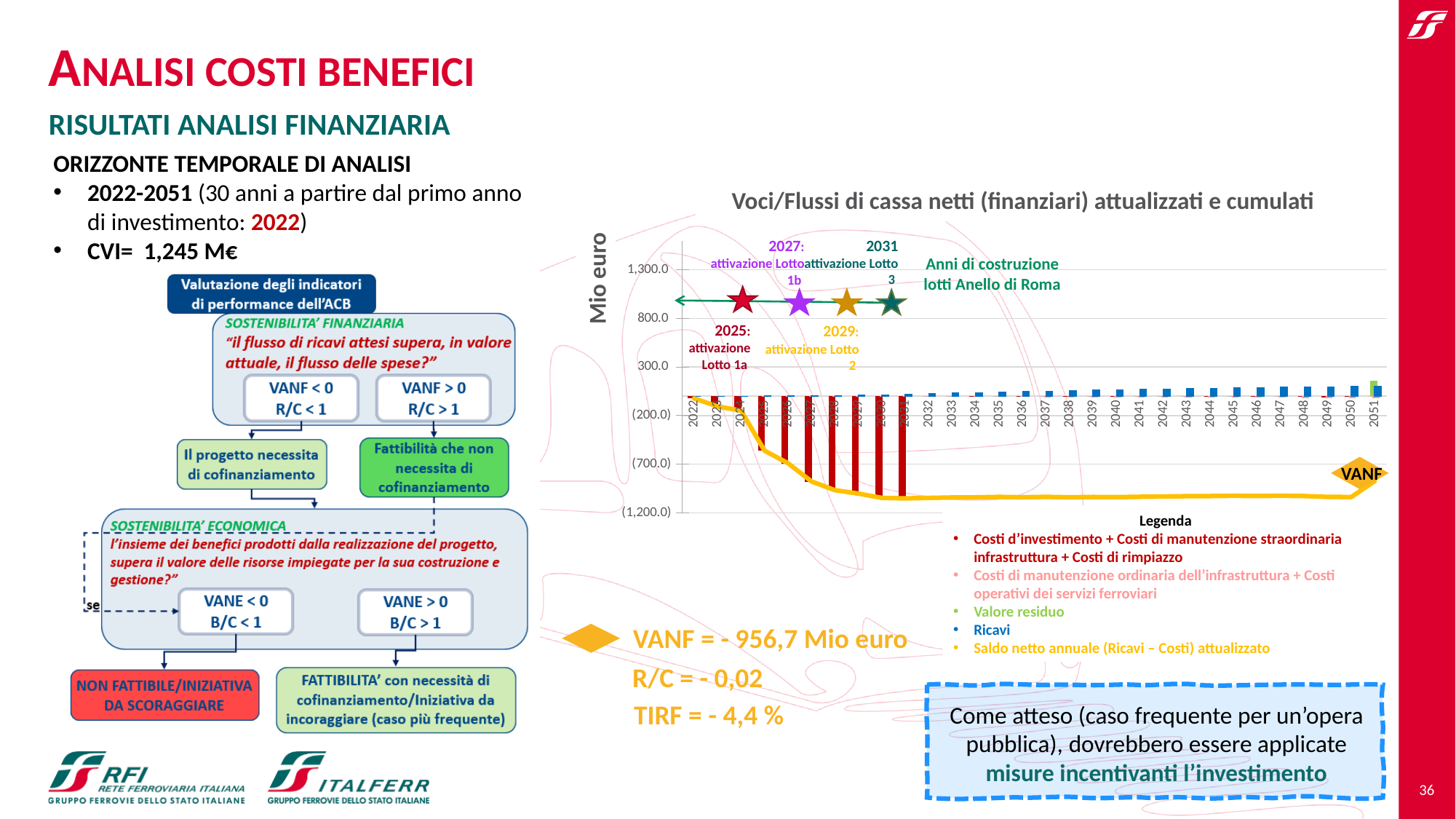
How many years are shown along the x axis of the chart? 30 What VANF value is stated next to the chart? - 956,7 Mio euro What is the title of the chart on the slide? Voci/Flussi di cassa netti (finanziari) attualizzati e cumulati Which year has a larger red cost bar, 2028 or 2035? 2028 What kind of chart is shown on the slide? Combined bar and line chart Is the value of the red cost bar in 2028 greater or less than (200.0)? less Which legend entry is shown in dark red? Costi d'investimento + Costi di manutenzione straordinaria infrastruttura + Costi di rimpiazzo How many entries does the chart's legend list? 5 Is the value of the yellow cumulative line in 2022 greater or less than (200.0)? greater Is the value of the yellow cumulative line in 2040 greater or less than (700.0)? less Does the yellow cumulative line (Saldo netto) rise or fall between 2022 and 2031? Falls In which year does the green 'Valore residuo' bar appear on the chart? 2051